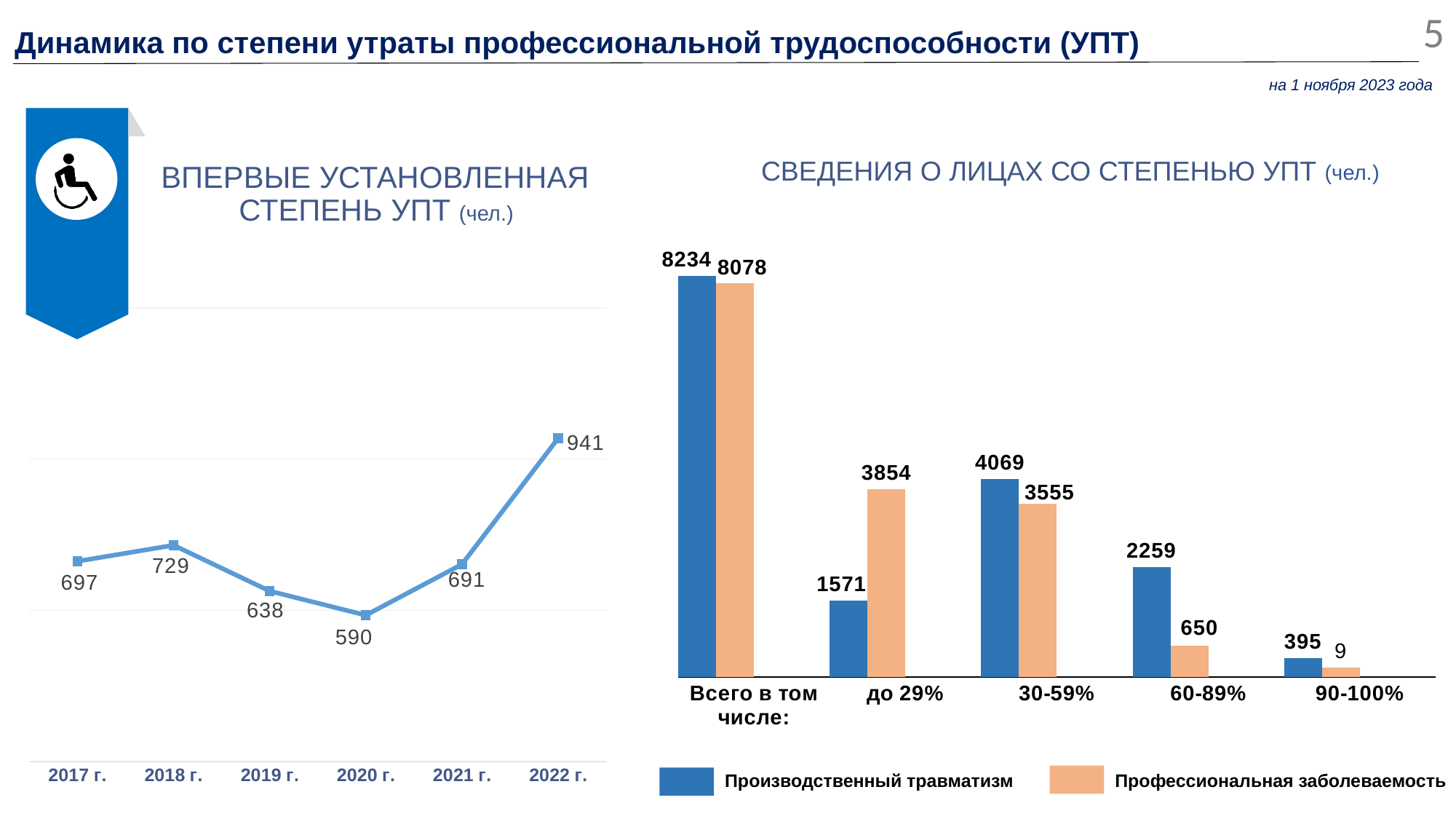
In the right chart 'СВЕДЕНИЯ О ЛИЦАХ СО СТЕПЕНЬЮ УПТ', what is the value of 'Профессиональная заболеваемость' for 'до 29%'? 3854 In the left chart 'ВПЕРВЫЕ УСТАНОВЛЕННАЯ СТЕПЕНЬ УПТ', what is the value for 2020 г.? 590 What kind of chart is the left chart 'ВПЕРВЫЕ УСТАНОВЛЕННАЯ СТЕПЕНЬ УПТ'? line chart In the right chart 'СВЕДЕНИЯ О ЛИЦАХ СО СТЕПЕНЬЮ УПТ', which is larger for '30-59%': 'Производственный травматизм' or 'Профессиональная заболеваемость'? Производственный травматизм In the left chart 'ВПЕРВЫЕ УСТАНОВЛЕННАЯ СТЕПЕНЬ УПТ', which year has the lowest value? 2020 г. In the right chart 'СВЕДЕНИЯ О ЛИЦАХ СО СТЕПЕНЬЮ УПТ', what is the value of 'Производственный травматизм' for '60-89%'? 2259 In the left chart 'ВПЕРВЫЕ УСТАНОВЛЕННАЯ СТЕПЕНЬ УПТ', which year has the highest value? 2022 г. In the left chart 'ВПЕРВЫЕ УСТАНОВЛЕННАЯ СТЕПЕНЬ УПТ', how many years are plotted? 6 In the left chart 'ВПЕРВЫЕ УСТАНОВЛЕННАЯ СТЕПЕНЬ УПТ', what is the difference between the values for 2022 г. and 2021 г.? 250 In the left chart 'ВПЕРВЫЕ УСТАНОВЛЕННАЯ СТЕПЕНЬ УПТ', do the values rise or fall from 2018 г. to 2020 г.? fall In the right chart 'СВЕДЕНИЯ О ЛИЦАХ СО СТЕПЕНЬЮ УПТ', what is the difference between 'Производственный травматизм' and 'Профессиональная заболеваемость' for '90-100%'? 386 How many series does the legend of the right chart 'СВЕДЕНИЯ О ЛИЦАХ СО СТЕПЕНЬЮ УПТ' list? 2